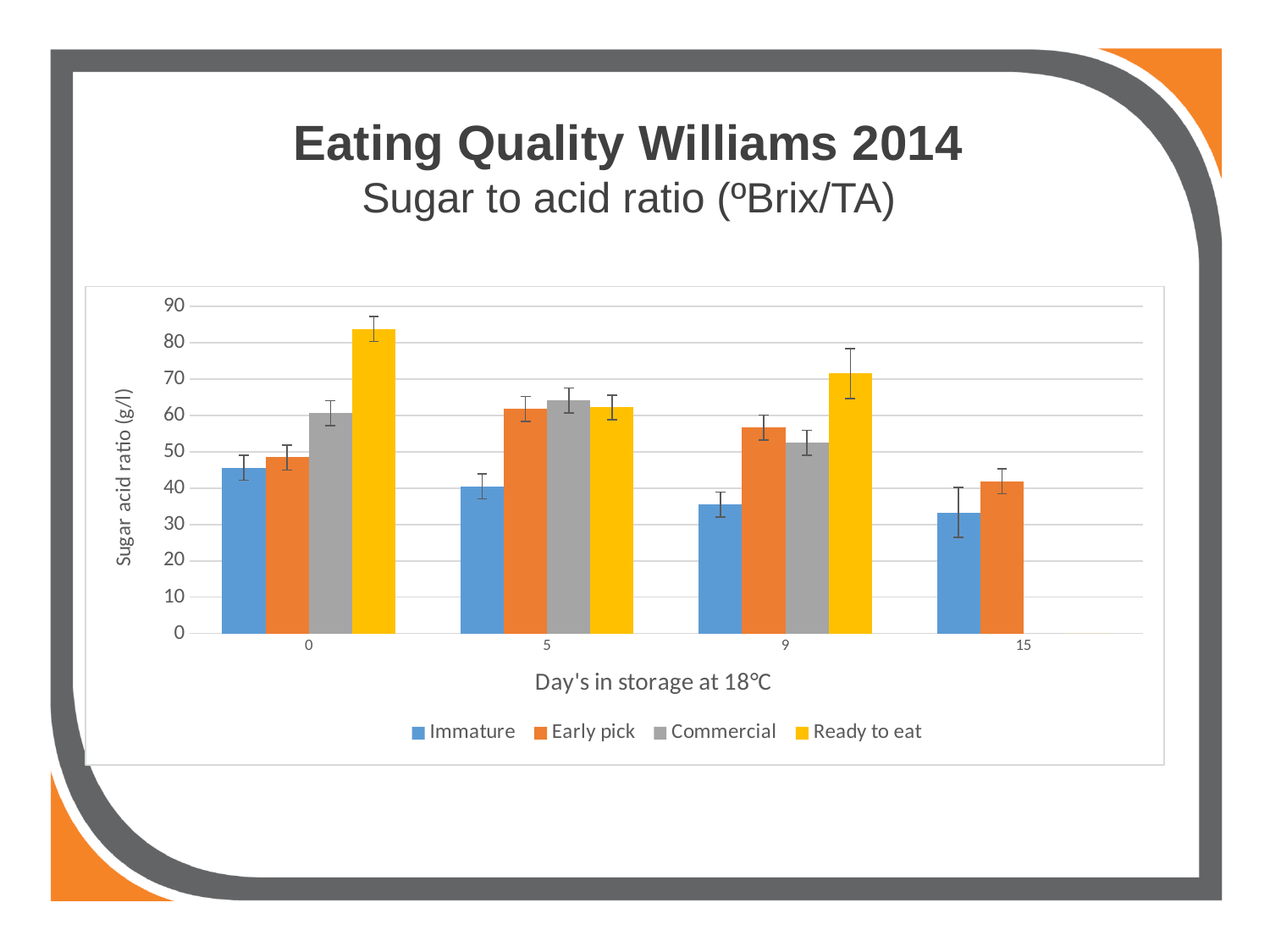
At day 9, which is larger: Early pick or Commercial? Early pick Is the value for Ready to eat at day 0 greater or less than 80? greater Is the value for Immature at day 9 greater or less than 40? less At day 0, which is larger: Commercial or Immature? Commercial Is the value for Ready to eat at day 9 greater or less than 60? greater Which series has the lowest bar at day 9? Immature Do the Immature values rise or fall as days in storage increase? fall What is the title of the y axis? Sugar acid ratio (g/l) How many storage-day categories are shown on the x axis? 4 What kind of chart is shown on the slide? bar chart Which series has the highest bar at day 0? Ready to eat How many series does the legend list? 4